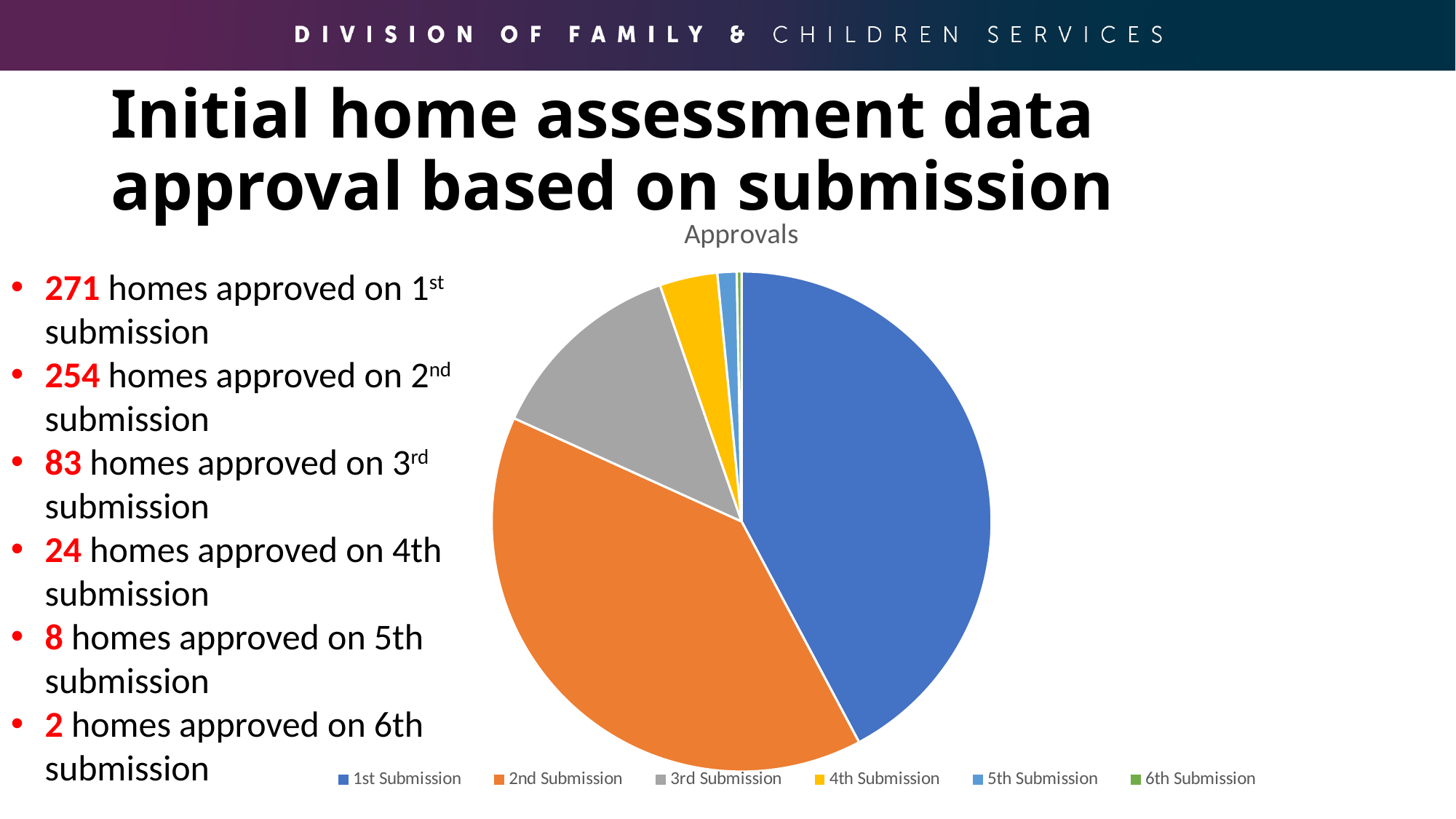
What is the difference between the number of homes approved on 1st submission and on 2nd submission? 17 What is the total number of homes approved across all six submissions? 642 Which submission has the smallest slice of the pie? 6th Submission Which slice is larger, 3rd Submission or 4th Submission? 3rd Submission What is the title of the chart? Approvals What colour is the 2nd Submission slice? orange Which submission has the largest slice of the pie? 1st Submission How many homes were approved on 3rd submission? 83 What kind of chart is shown on the slide? pie chart How many entries does the chart legend list? 6 How many slices does the pie chart have? 6 How many homes were approved on 1st submission? 271